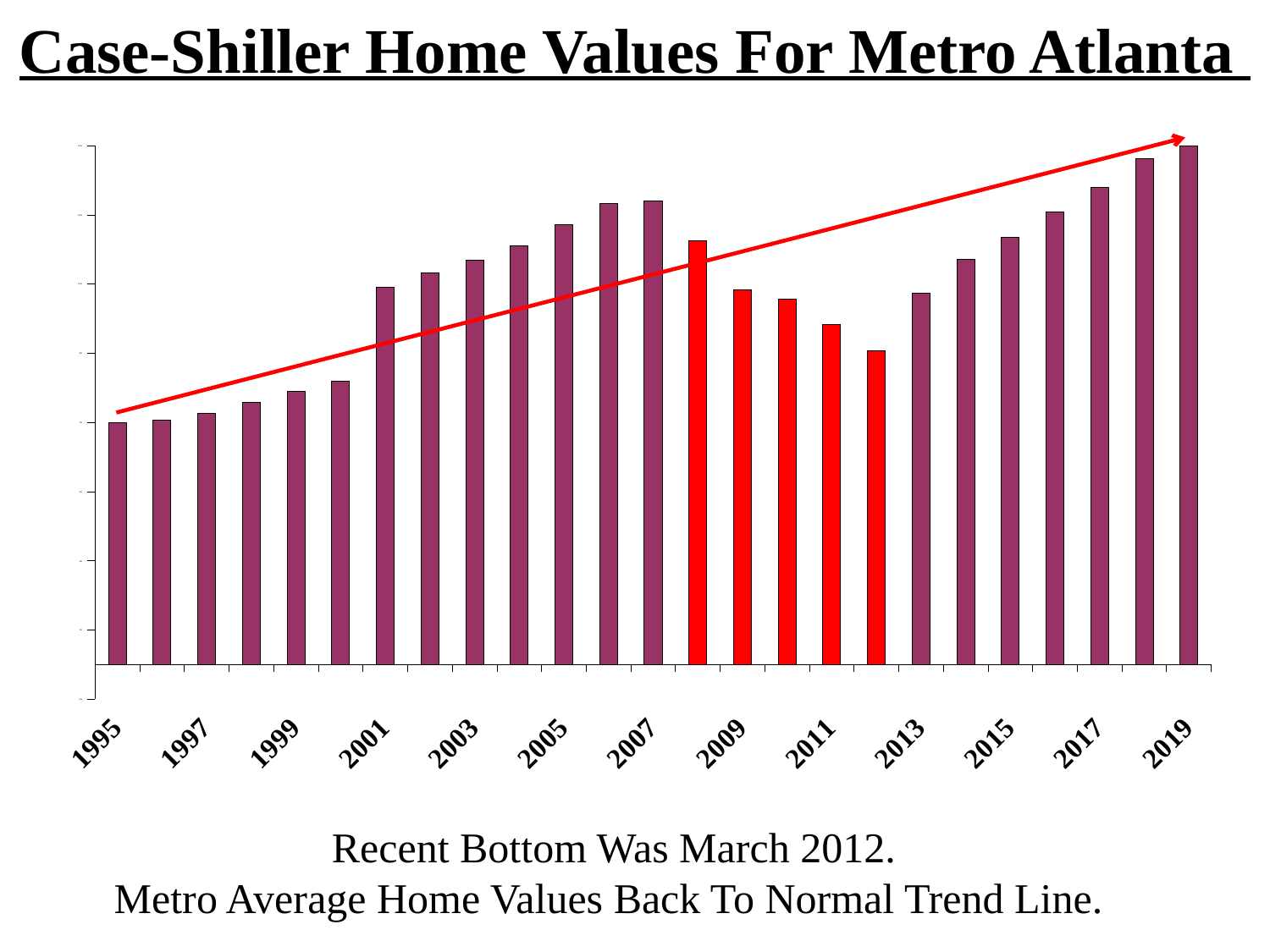
What kind of chart is shown on the slide? bar chart How many bars are plotted in the chart? 25 Do the values rise or fall from 1995 to 2007? rise Which is larger, the value for 2007 or the value for 2011? 2007 Which year has the highest bar in the chart? 2019 Do the values rise or fall from 2013 to 2019? rise Which is larger, the value for 2001 or the value for 1999? 2001 Do the values rise or fall from 2007 to 2011? fall What is the title of the chart on the slide? Case-Shiller Home Values For Metro Atlanta Which is larger, the value for 2003 or the value for 2013? 2003 How many bars in the chart are coloured bright red? 5